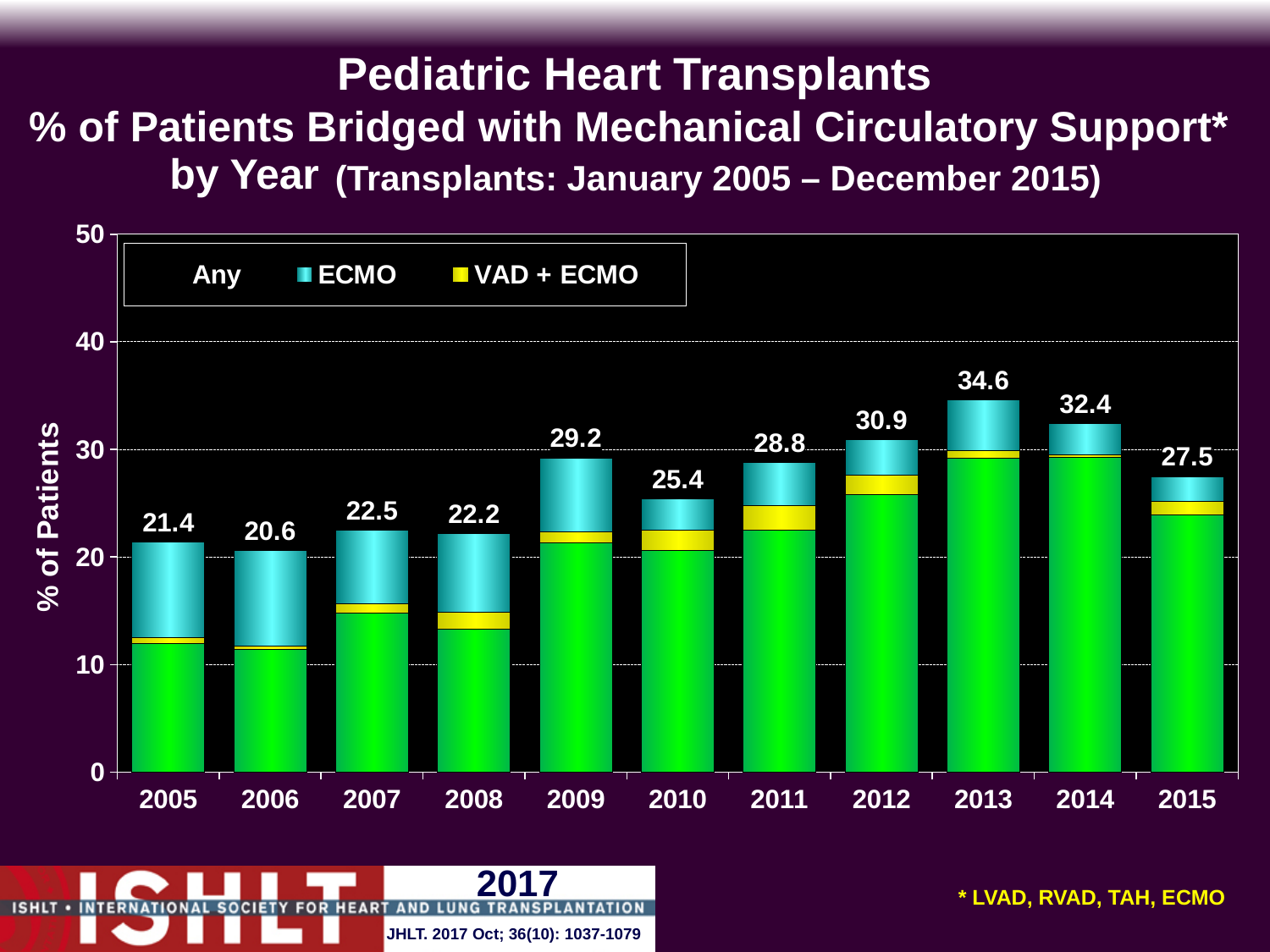
What is the total percentage of patients bridged with mechanical circulatory support in 2013? 34.6 What is the total value labeled above the bar for 2009? 29.2 Which year has a larger total, 2010 or 2011? 2011 What is the label on the y axis? % of Patients What is the difference between the total for 2013 and the total for 2006? 14.0 What kind of chart is shown on the slide? Stacked bar chart Which year has the lowest total percentage of patients bridged with mechanical circulatory support? 2006 Is the green (Any) segment of the 2005 bar greater or less than 10? greater What is the total value labeled above the bar for 2015? 27.5 How many series does the legend list? 3 Which year has the highest total percentage of patients bridged with mechanical circulatory support? 2013 How many years are shown on the x axis? 11